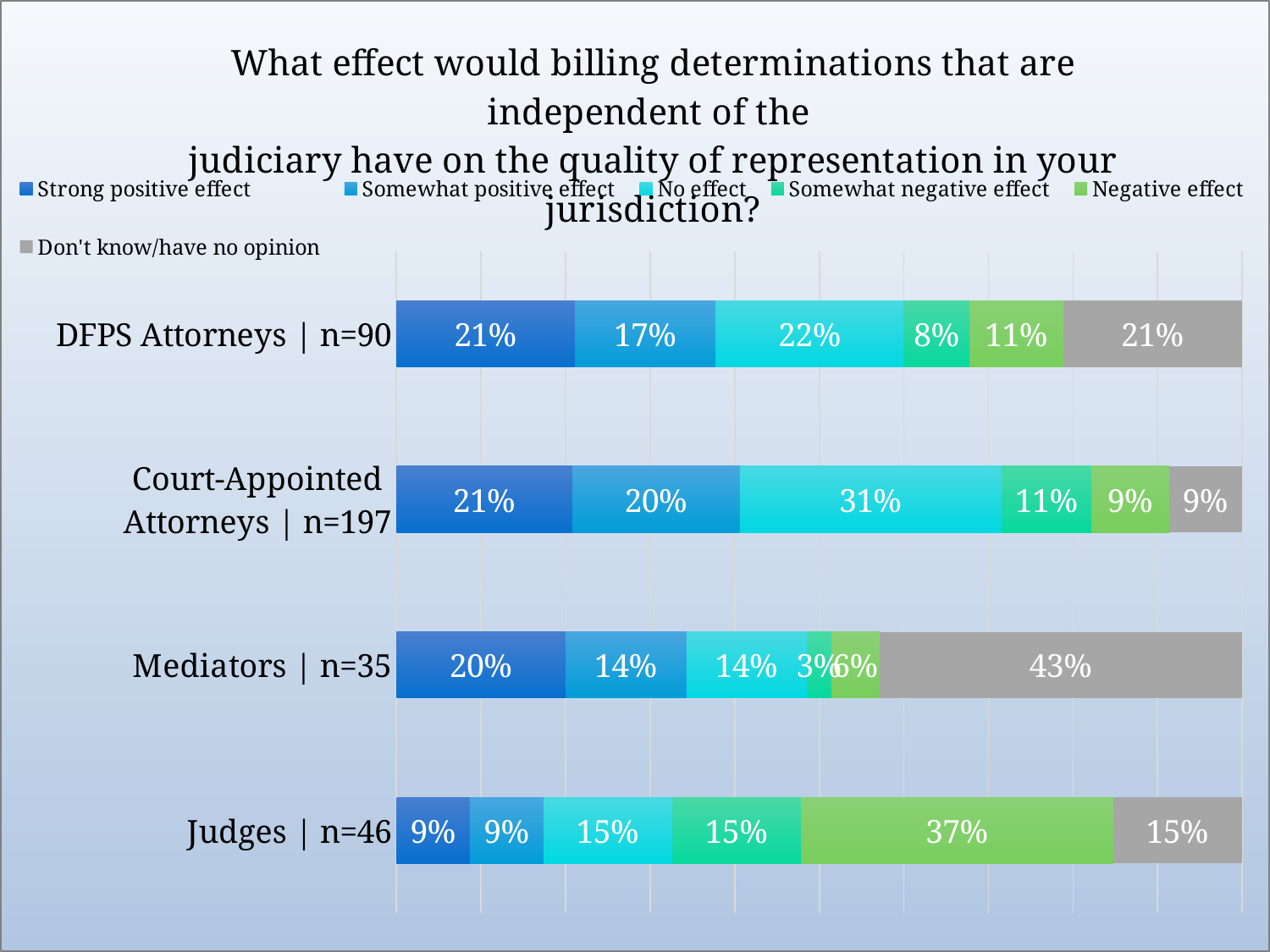
What percentage of DFPS Attorneys reported a "Strong positive effect"? 21% Which respondent group has the lowest percentage for "Strong positive effect"? Judges | n=46 What percentage of Mediators answered "Don't know/have no opinion"? 43% How many respondent groups are shown in the chart? 4 What is the difference between the "No effect" percentage for Court-Appointed Attorneys and for DFPS Attorneys? 9% How many series does the legend list? 6 Which respondent group has the highest percentage for "Don't know/have no opinion"? Mediators | n=35 What percentage of Judges reported a "Negative effect"? 37% What is the sample size (n) shown for Court-Appointed Attorneys? 197 What percentage of Court-Appointed Attorneys reported "No effect"? 31% Which is larger: the "Negative effect" percentage for Judges or for DFPS Attorneys? Judges What kind of chart is shown on the slide? Stacked bar chart